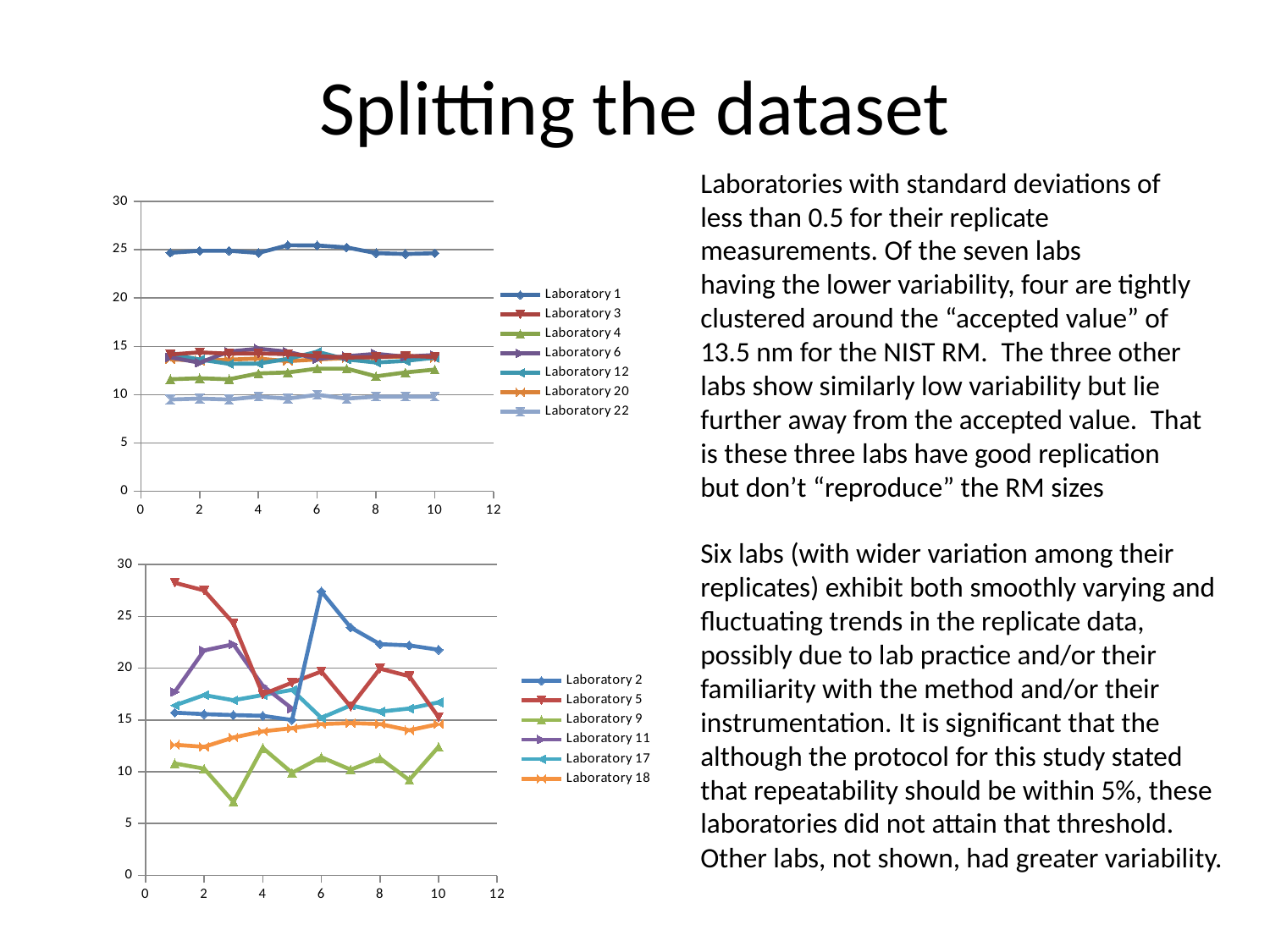
In the bottom chart, which is larger at x = 2: Laboratory 5 or Laboratory 9? Laboratory 5 What kind of chart is the top chart on the slide? line chart In the top chart, are the values for Laboratory 1 greater or less than 20? greater How many series does the legend of the bottom chart list? 6 In the top chart, how many data points are plotted for Laboratory 1? 10 In the top chart, which laboratory series has the highest values? Laboratory 1 In the bottom chart, which laboratory series is plotted in green? Laboratory 9 In the bottom chart, are the values for Laboratory 9 greater or less than 15? less In the top chart, which laboratory series has the lowest values? Laboratory 22 How many series does the legend of the top chart list? 7 In the top chart, are the values for Laboratory 22 greater or less than 15? less